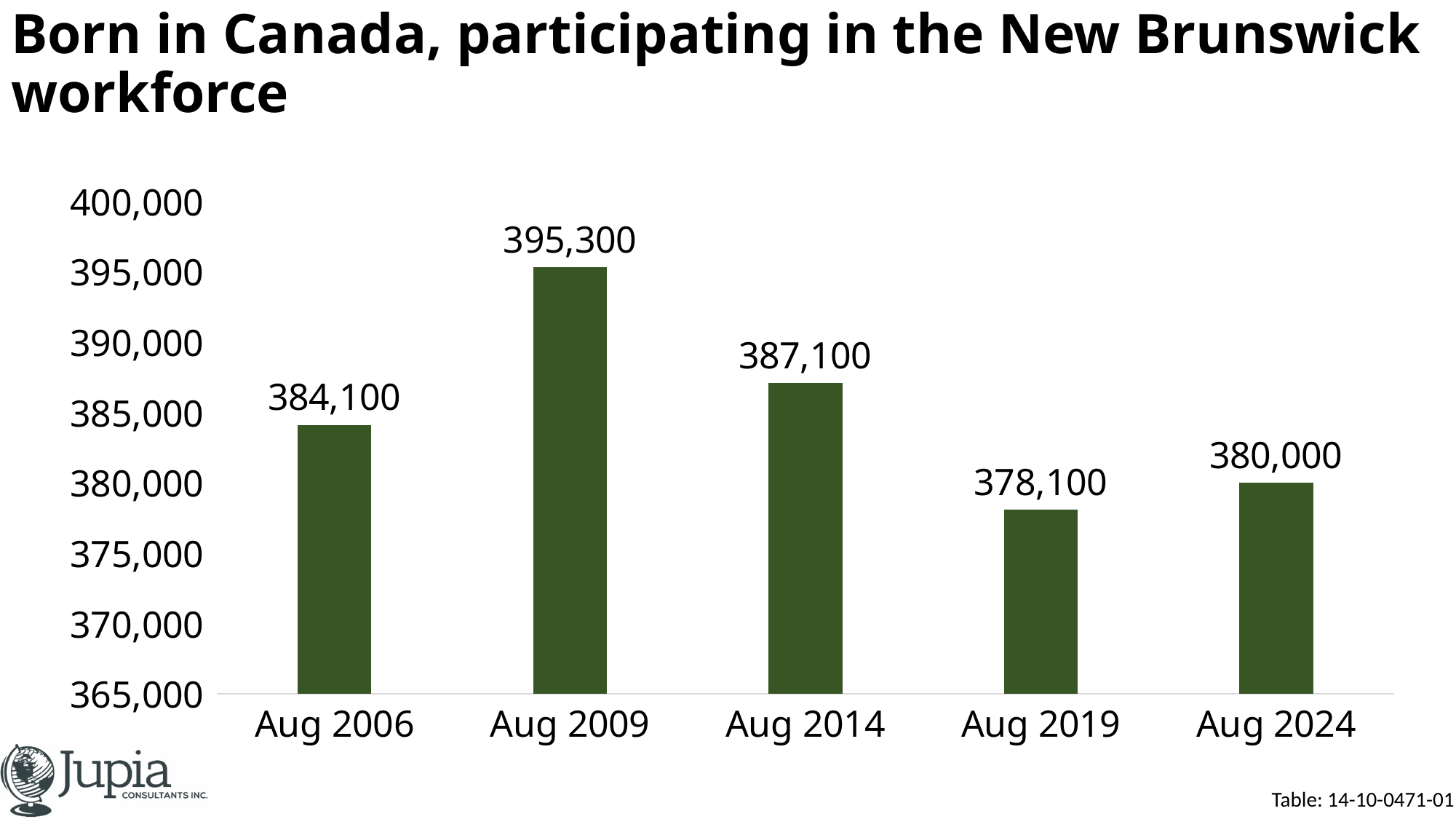
What is the difference between the values for Aug 2009 and Aug 2006? 11,200 Is the value for Aug 2019 greater or less than 380,000? less What kind of chart is shown on the slide? bar chart What is the value for Aug 2019? 378,100 How many periods are shown on the x axis? 5 Which period has the lowest value? Aug 2019 What is the value for Aug 2009? 395,300 What is the difference between the values for Aug 2014 and Aug 2024? 7,100 Which is larger, the value for Aug 2006 or the value for Aug 2014? Aug 2014 Which period has the highest value? Aug 2009 What is the value for Aug 2024? 380,000 What is the title of the chart? Born in Canada, participating in the New Brunswick workforce